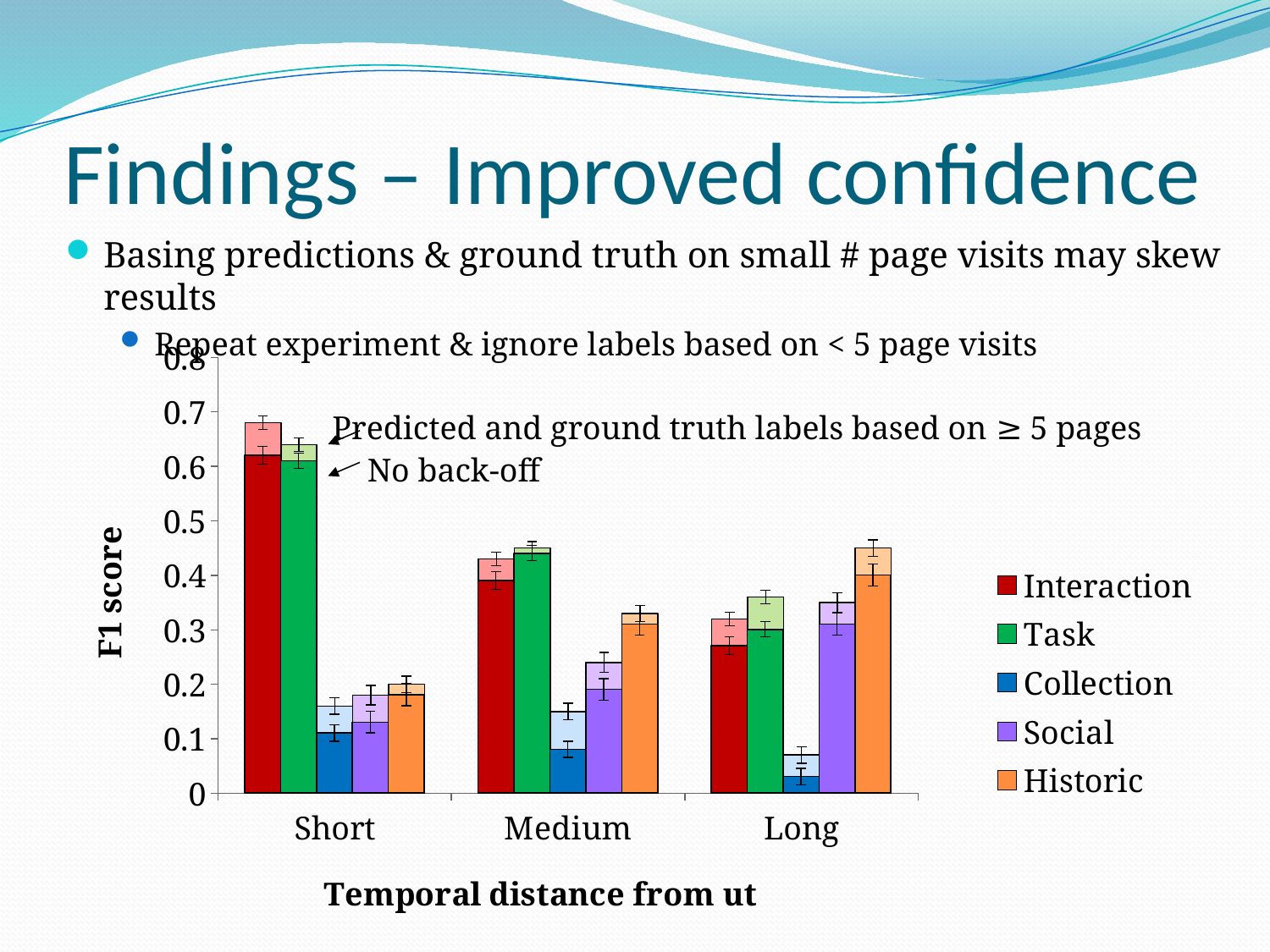
What kind of chart is shown on the slide? bar chart Which series has the lowest F1 score in the Long category? Collection Which series has the highest F1 score in the Long category? Historic Is the Collection F1 score for Medium greater or less than 0.2? less Is the Historic F1 score for Long greater or less than 0.3? greater What is the label of the y axis? F1 score In the Short category, which is larger: the Interaction F1 score or the Collection F1 score? Interaction Does the Interaction F1 score rise or fall from Short to Long? fall How many categories are shown on the x axis? 3 Is the Interaction F1 score for Short greater or less than 0.5? greater Which temporal distance category has the highest Interaction F1 score? Short How many series does the legend list? 5